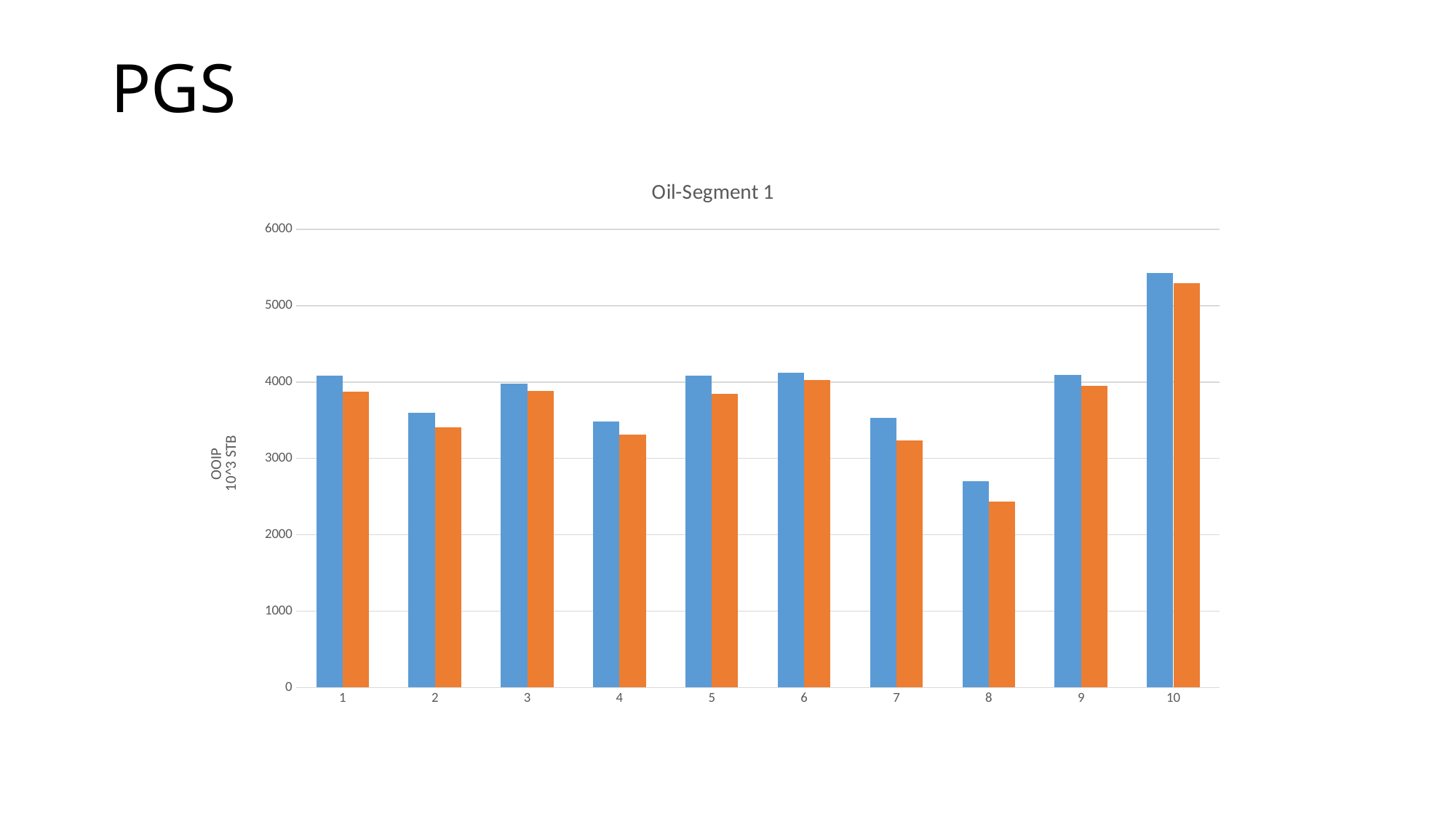
What is the label on the vertical axis of the chart? OOIP 10^3 STB Which category has the highest bars in the chart? 10 Which category has the lowest bars in the chart? 8 How many categories are shown on the x axis of the chart? 10 Is the value of the blue bar for category 10 greater or less than 5000? greater For category 8, which bar is larger, the blue one or the orange one? blue What type of chart is shown on the slide? Bar chart What is the title of the chart? Oil-Segment 1 Is the value of the orange bar for category 8 greater or less than 3000? less Which is larger, the orange bar for category 7 or the orange bar for category 8? category 7 Is the value of the blue bar for category 2 greater or less than 3000? greater